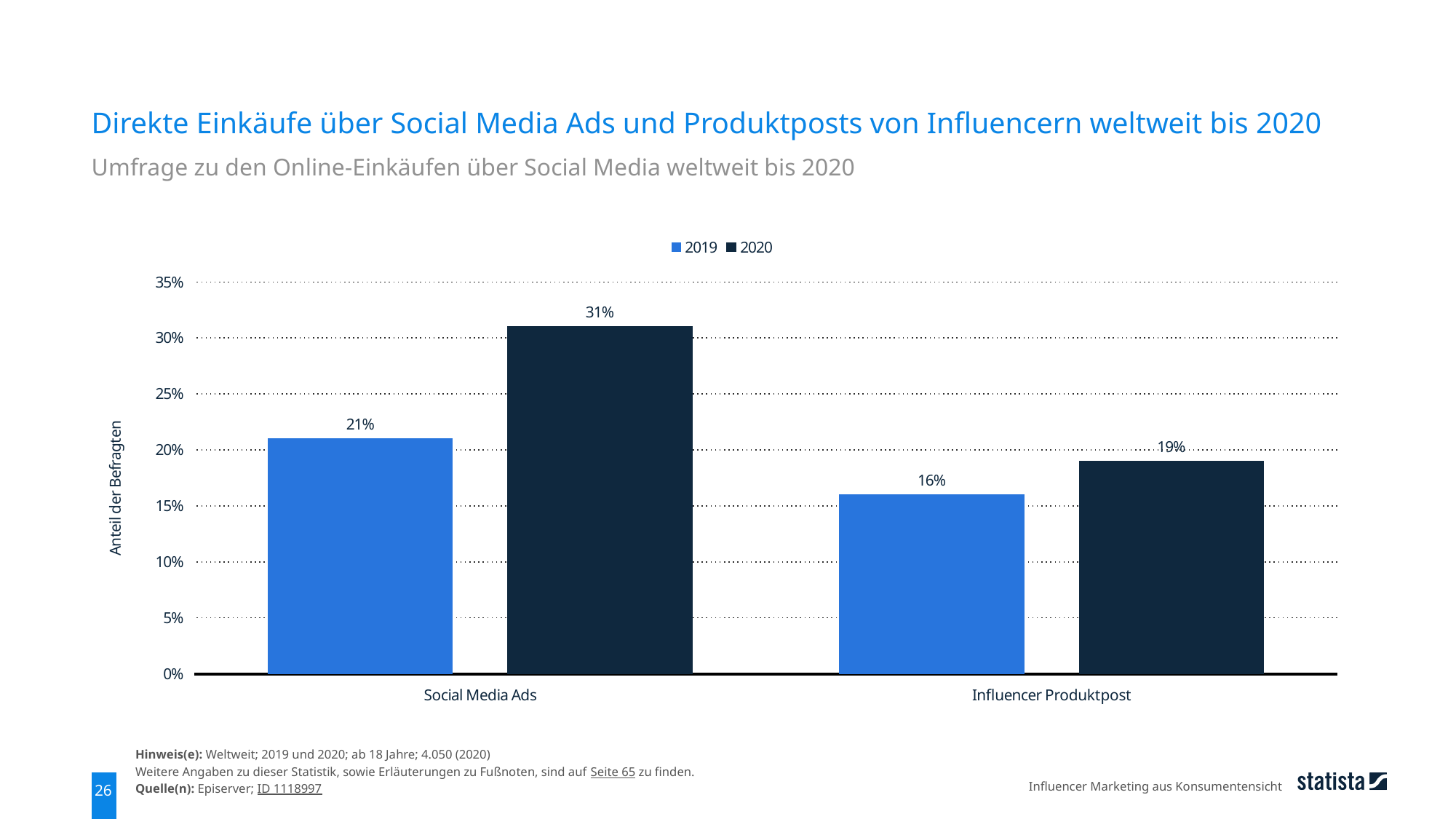
What is the difference between the 2020 and 2019 values for Social Media Ads? 10% What is the value for Social Media Ads in 2020? 31% What is the difference between the 2020 and 2019 values for Influencer Produktpost? 3% How many categories are shown on the x axis? 2 How many series does the legend list? 2 Which is larger: the 2019 value for Social Media Ads or the 2020 value for Influencer Produktpost? 2019 value for Social Media Ads What is the value for Influencer Produktpost in 2020? 19% What is the value for Influencer Produktpost in 2019? 16% What kind of chart is shown on the slide? Bar chart Which category has the highest value in 2020? Social Media Ads What is the value for Social Media Ads in 2019? 21% Which category has the lowest value in 2019? Influencer Produktpost